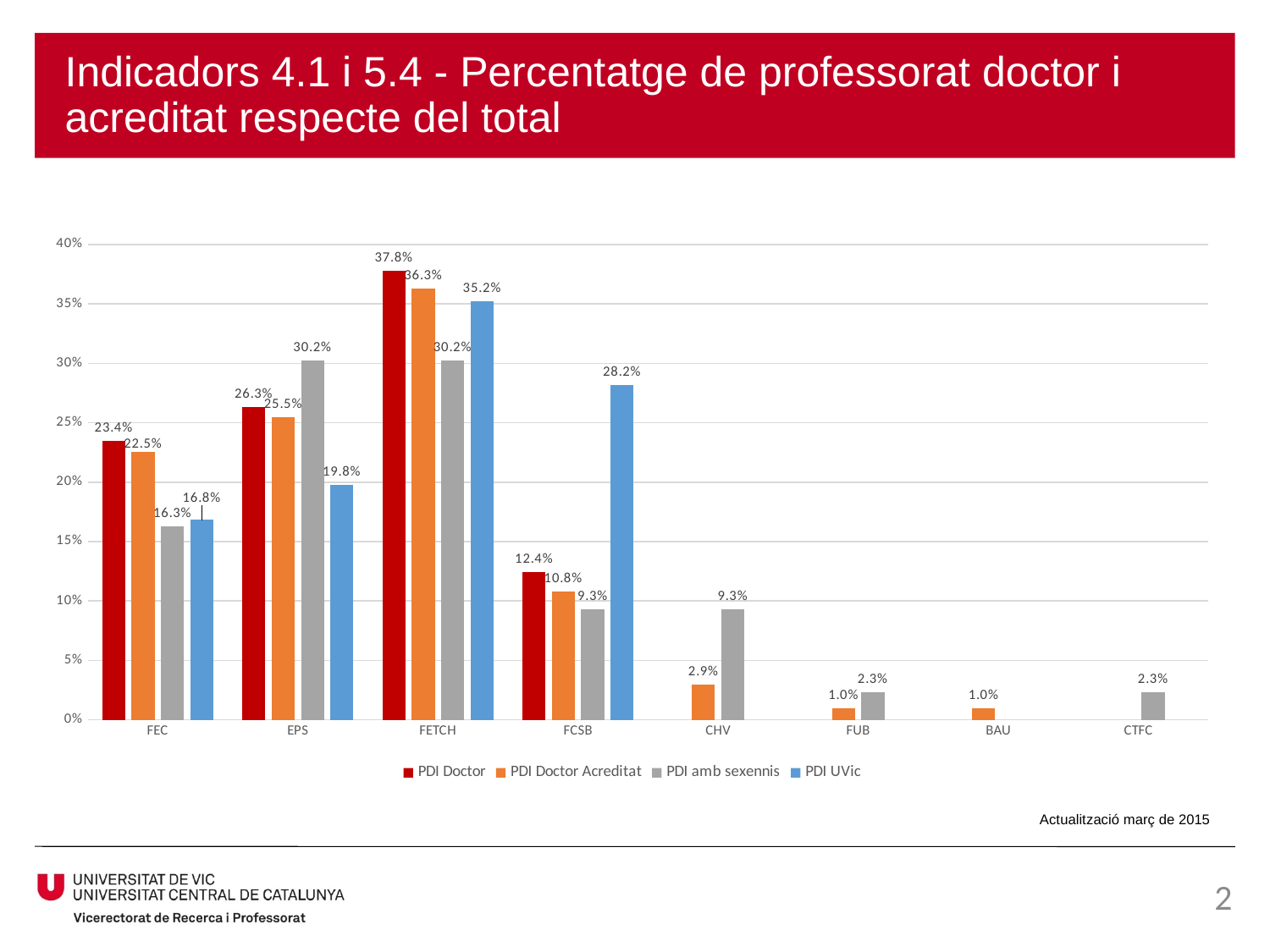
Which is larger for EPS: the PDI amb sexennis value or the PDI UVic value? PDI amb sexennis What type of chart is shown on the slide? bar chart What is the PDI UVic value for FCSB? 28.2% How many categories are shown on the x axis? 8 How many series does the legend list? 4 What is the difference between the PDI Doctor value for FETCH and the PDI Doctor value for FCSB? 25.4% Is the PDI Doctor Acreditat value for FEC greater or less than 20%? greater Which category has the highest PDI Doctor value? FETCH Which series is shown in blue in the legend? PDI UVic Which category has the lowest PDI UVic value? FEC What is the PDI Doctor value for FETCH? 37.8% What is the PDI amb sexennis value for CHV? 9.3%